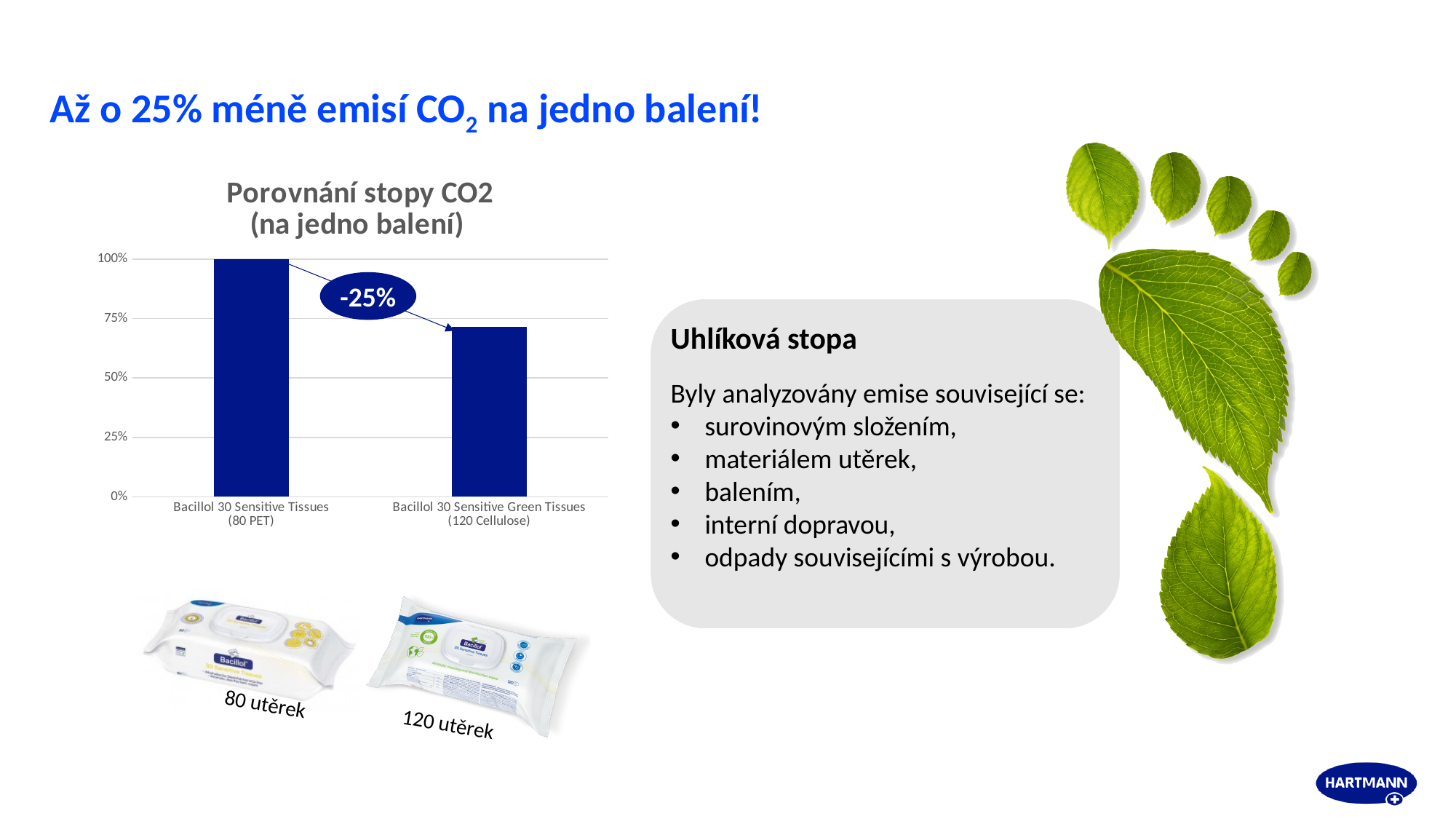
Which category has the lowest value in the chart? Bacillol 30 Sensitive Green Tissues (120 Cellulose) Do the values rise or fall from the left bar to the right bar? fall Which category has the highest value in the chart? Bacillol 30 Sensitive Tissues (80 PET) How many categories (bars) does the chart show? 2 What kind of chart is shown on the slide? bar chart What is the value for Bacillol 30 Sensitive Tissues (80 PET)? 100% Is the value for Bacillol 30 Sensitive Green Tissues (120 Cellulose) greater or less than 50%? greater Which is larger: the value for Bacillol 30 Sensitive Tissues (80 PET) or for Bacillol 30 Sensitive Green Tissues (120 Cellulose)? Bacillol 30 Sensitive Tissues (80 PET) Is the value for Bacillol 30 Sensitive Green Tissues (120 Cellulose) greater or less than 75%? less What is the title of the chart? Porovnání stopy CO2 (na jedno balení) What label is shown in the oval annotation between the two bars? -25%